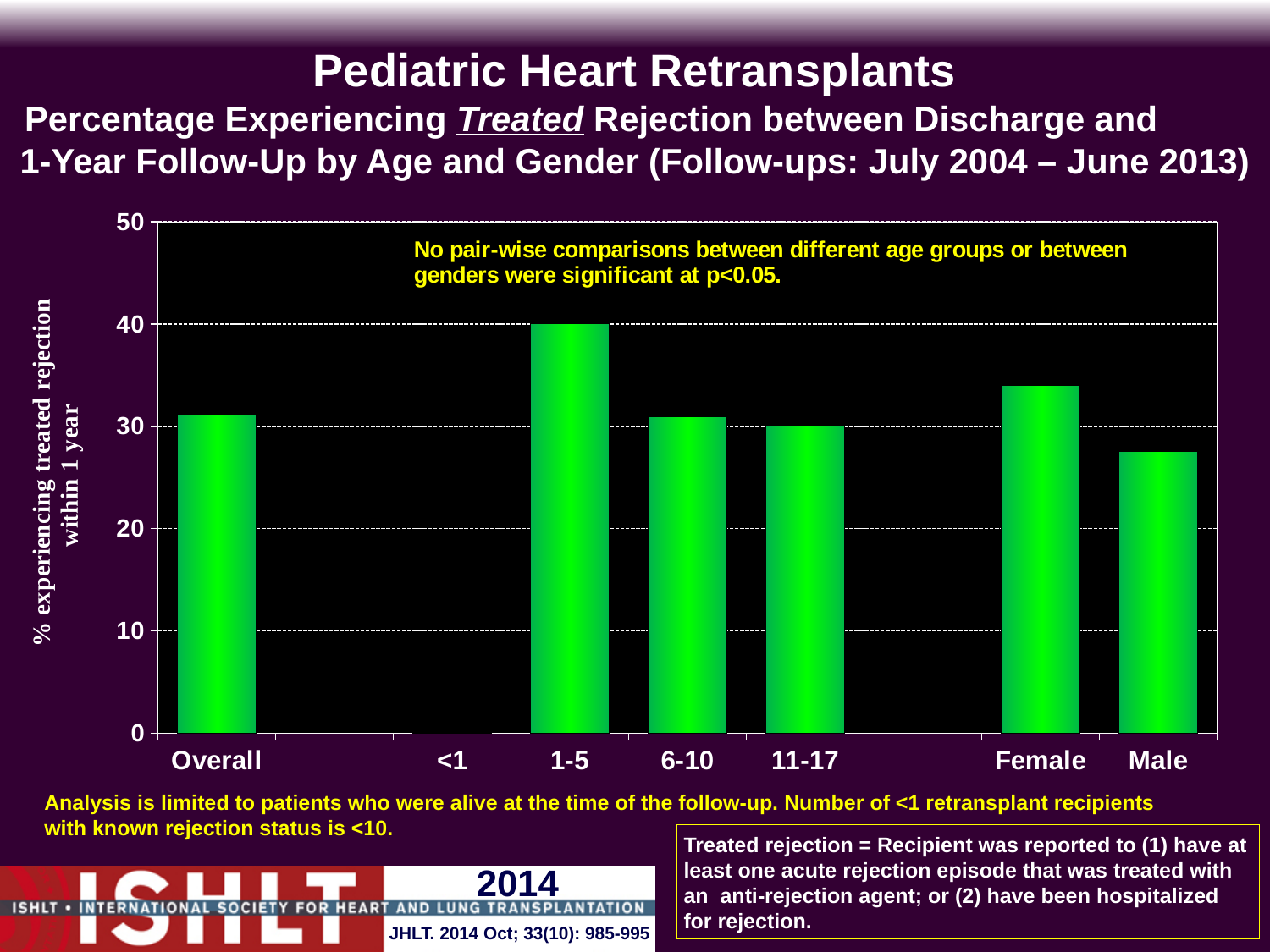
Which category on the x axis has no bar plotted? <1 Which category has the highest percentage experiencing treated rejection? 1-5 How many bars are plotted in the chart? 6 What kind of chart is shown on the slide? bar chart Is the value for Female greater or less than 30? greater What is the label of the y axis? % experiencing treated rejection within 1 year Which has a higher percentage experiencing treated rejection, the 1-5 age group or the 6-10 age group? 1-5 Which has a higher percentage experiencing treated rejection, Female or Male? Female Is the value for Male greater or less than 30? less Is the value for the 1-5 age group greater or less than 30? greater Among the categories with a plotted bar, which has the lowest percentage experiencing treated rejection? Male